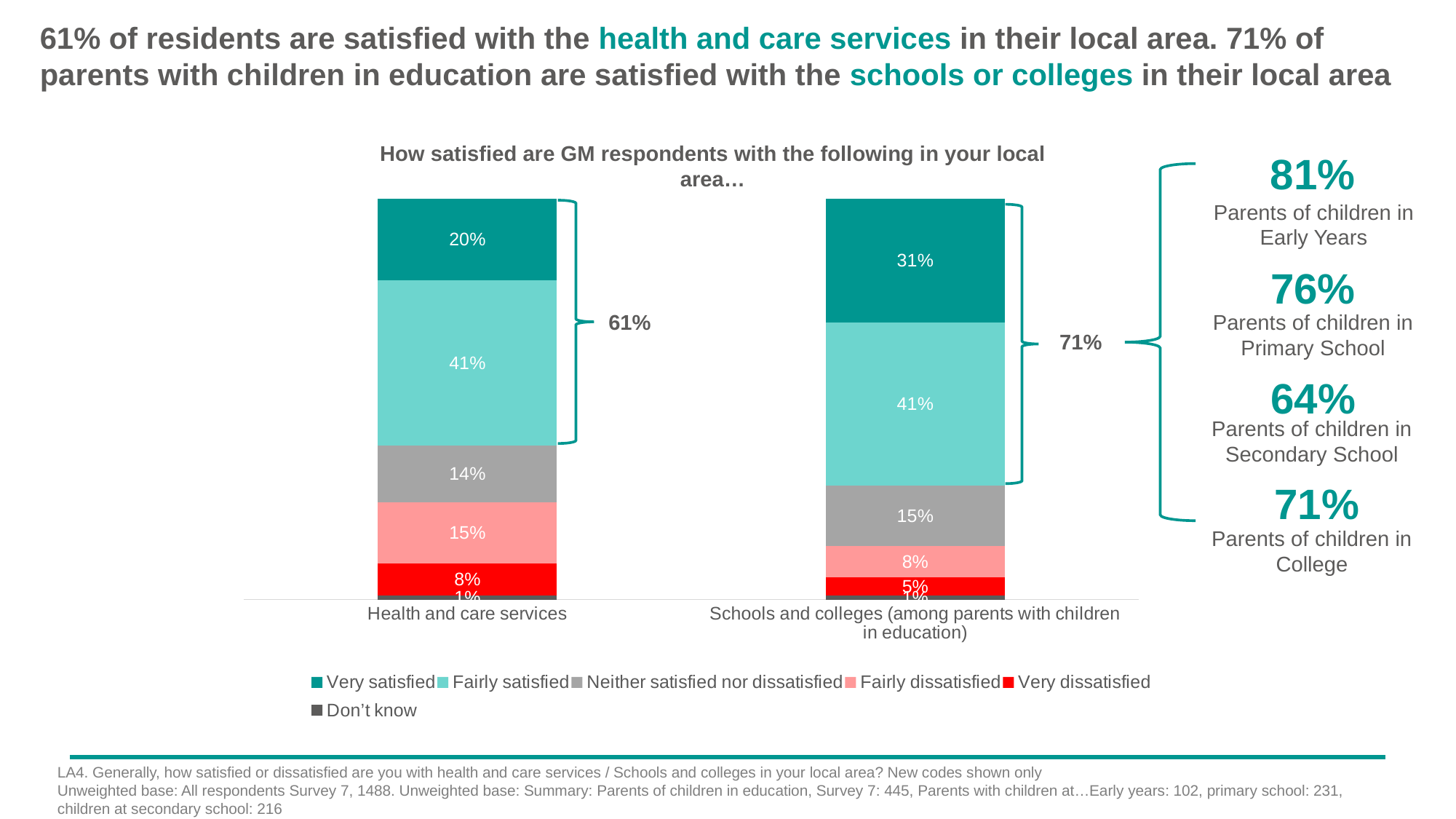
What is the combined satisfied (very plus fairly satisfied) share shown for health and care services? 61% Which category has the larger very dissatisfied share, health and care services or schools and colleges? Health and care services What percentage of respondents are neither satisfied nor dissatisfied with schools and colleges? 15% What percentage of respondents are very satisfied with health and care services? 20% What percentage of respondents are very dissatisfied with schools and colleges? 5% What is the combined satisfied (very plus fairly satisfied) share shown for schools and colleges? 71% What percentage of respondents are fairly dissatisfied with health and care services? 15% How many series does the legend list? 6 How much higher is the very satisfied share for schools and colleges than for health and care services? 11 percentage points What kind of chart is shown on the slide? Stacked bar chart What percentage of parents with children in education are very satisfied with schools and colleges? 31% How many categories (bars) are shown in the chart? 2